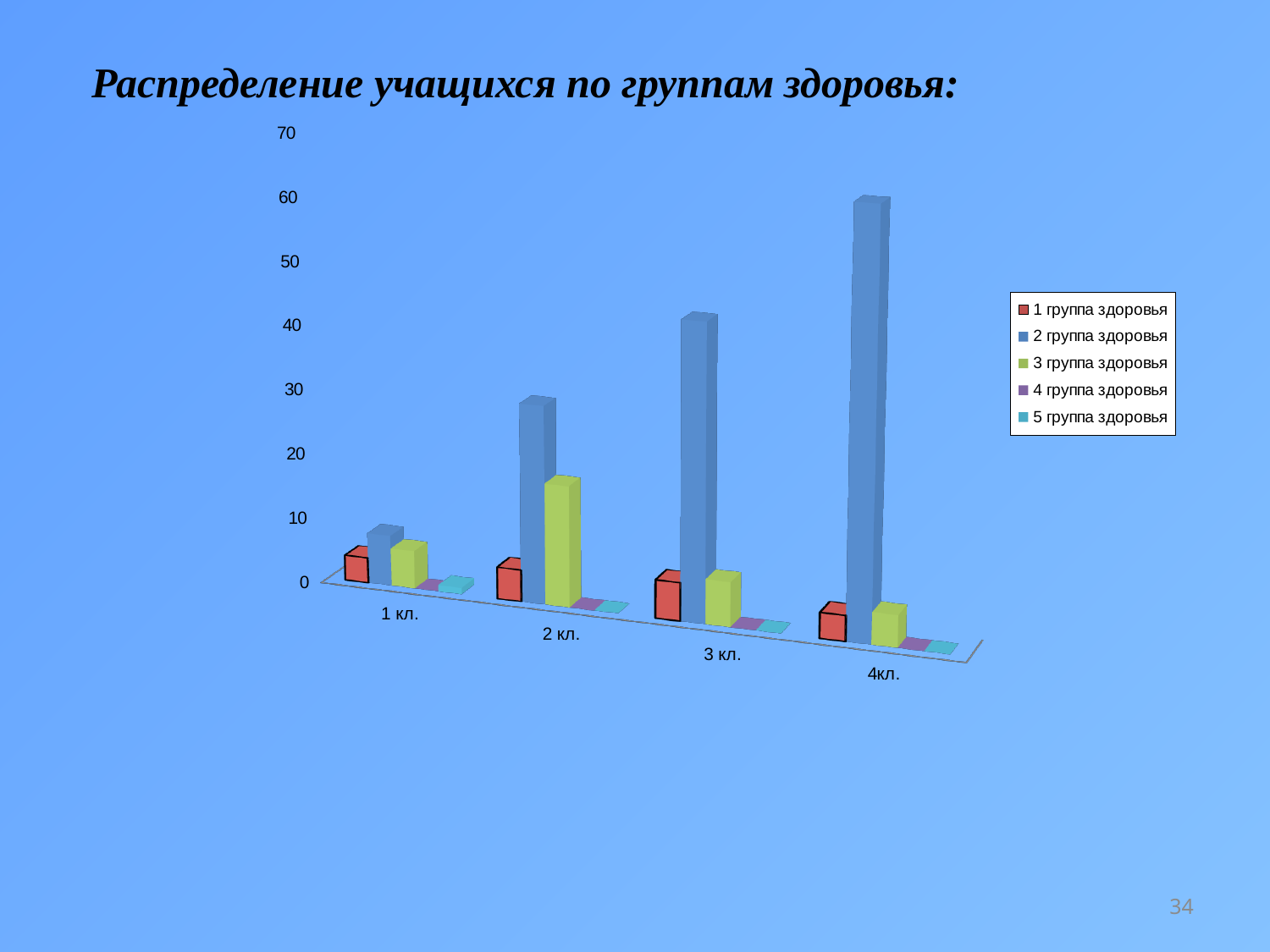
Is the value for 2 группа здоровья in 4кл. greater or less than 50? greater How many classes (categories) are shown on the x axis? 4 Do the values for 2 группа здоровья rise or fall from 1 кл. to 4кл.? rise Is the value for 3 группа здоровья in 2 кл. greater or less than 10? greater Which class has the lowest value for 2 группа здоровья? 1 кл. Is the value for 2 группа здоровья in 3 кл. greater or less than 30? greater How many series does the legend list? 5 What is the title of the chart? Распределение учащихся по группам здоровья: In 2 кл., which is larger: 2 группа здоровья or 3 группа здоровья? 2 группа здоровья What kind of chart is shown on the slide? bar chart Which class has the highest value for 2 группа здоровья? 4кл.